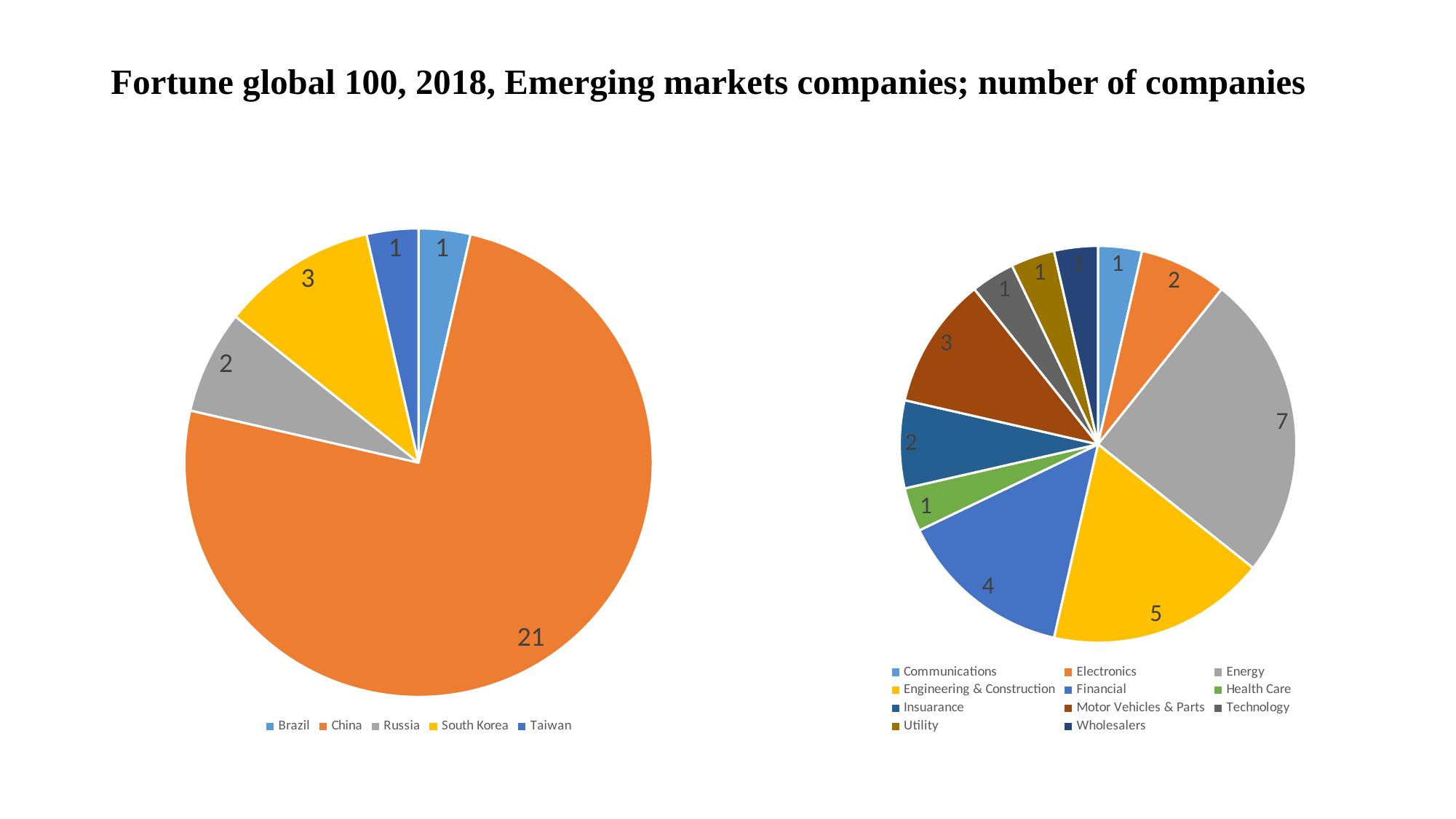
What type of chart is used on the left side of the slide? Pie chart On the left pie chart, which country has the largest slice? China On the left pie chart, how many companies are from South Korea? 3 On the left pie chart, what is the difference between the number of companies from China and from Russia? 19 On the right pie chart, how many sectors are listed in the legend? 11 On the left pie chart, how many countries are shown? 5 On the right pie chart, how many companies are in the Financial sector? 4 On the left pie chart, how many companies are from China? 21 On the left pie chart, what share of the total do the China companies represent? 75% On the right pie chart, which sector has the largest slice? Energy On the right pie chart, which is larger, Engineering & Construction or Motor Vehicles & Parts? Engineering & Construction On the right pie chart, how many companies are in the Energy sector? 7